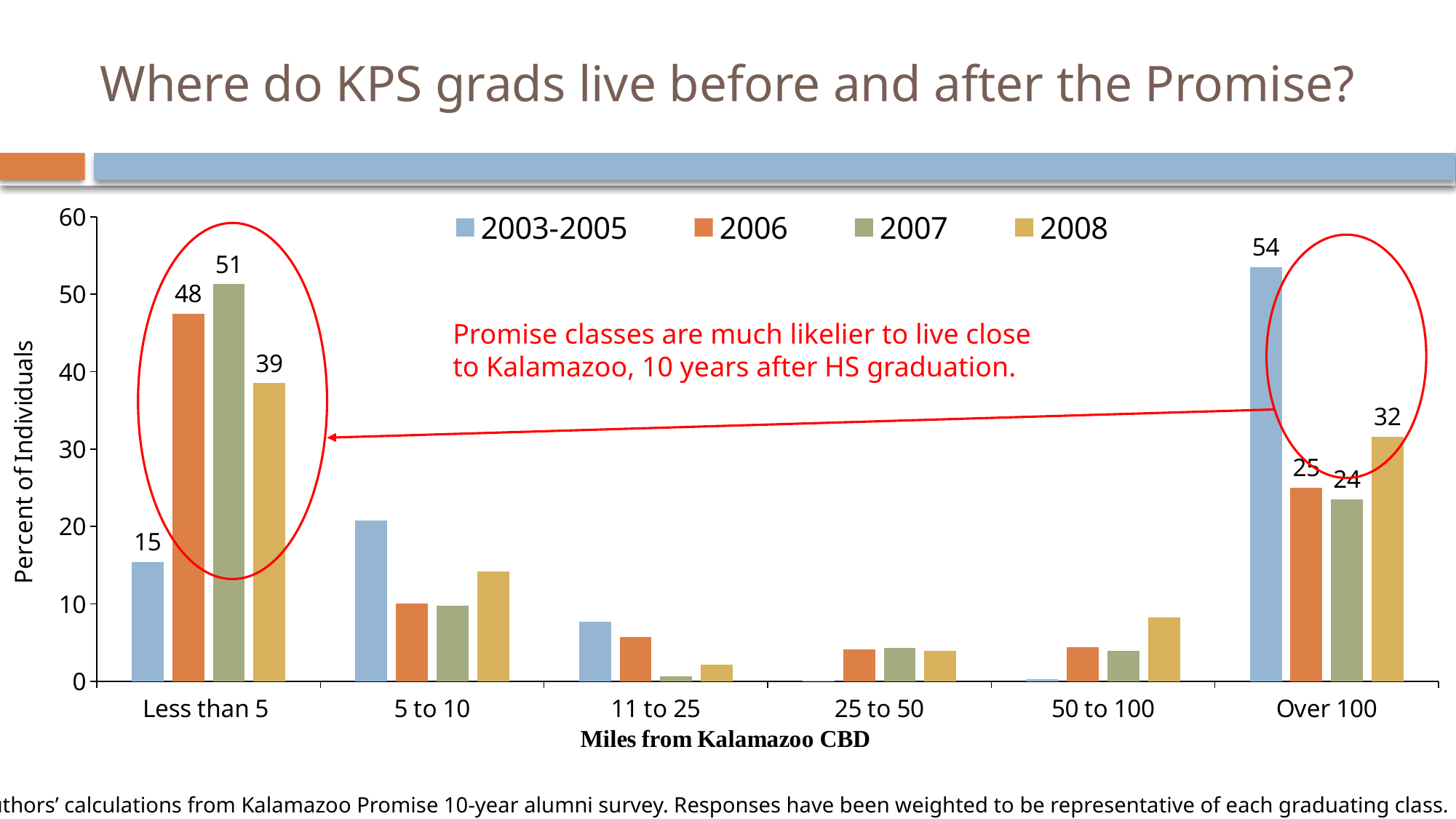
What kind of chart is shown on the slide? Bar chart What is the difference between the 2006 and 2003-2005 values in the "Less than 5" category? 33 What is the value for the 2008 series in the "Less than 5" category? 39 In the "Over 100" category, which is larger: the 2003-2005 value or the 2008 value? 2003-2005 Is the value for the 2008 series in the "50 to 100" category greater or less than 10? less How many distance categories are shown on the x axis? 6 Is the value for the 2003-2005 series in the "5 to 10" category greater or less than 20? greater What is the value for the 2007 series in the "Less than 5" category? 51 How many series does the legend list? 4 What is the value for the 2003-2005 series in the "Over 100" category? 54 Which series has the highest value in the "Less than 5" category? 2007 Which series has the lowest value in the "Over 100" category? 2007